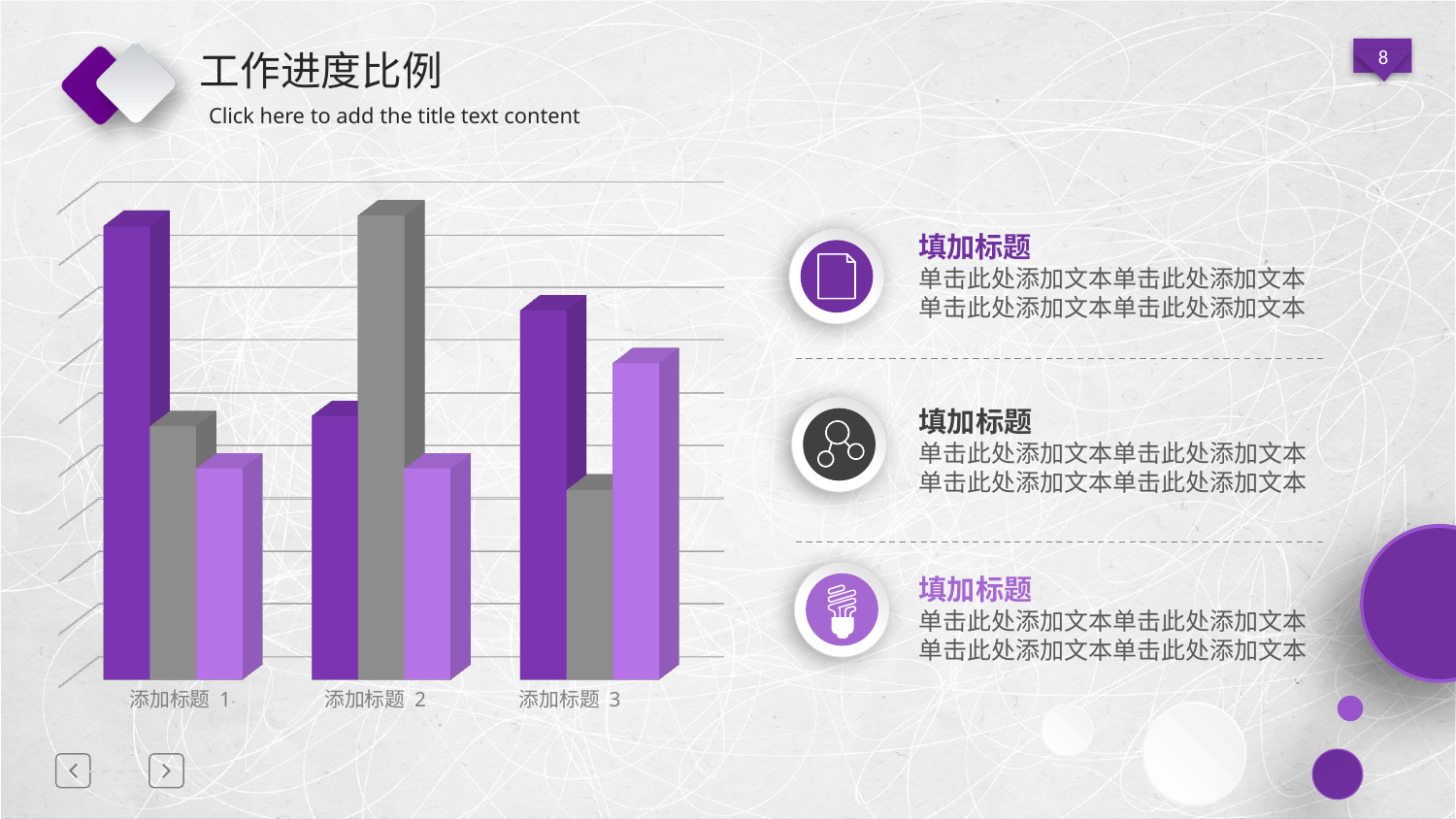
Which category has the tallest light purple bar? 添加标题 3 What kind of chart is shown on the slide? bar chart How many categories are shown on the x axis of the chart? 3 Which category has the shortest dark purple bar? 添加标题 2 Does the gray bar rise or fall from 添加标题 2 to 添加标题 3? fall Which category has the tallest dark purple bar? 添加标题 1 How many bars are plotted for each category in the chart? 3 In 添加标题 2, which bar is taller: the dark purple bar or the gray bar? the gray bar Which category has the tallest gray bar? 添加标题 2 Which category has the shortest gray bar? 添加标题 3 What is the title of the slide containing the chart? 工作进度比例 In 添加标题 3, which bar is taller: the gray bar or the light purple bar? the light purple bar